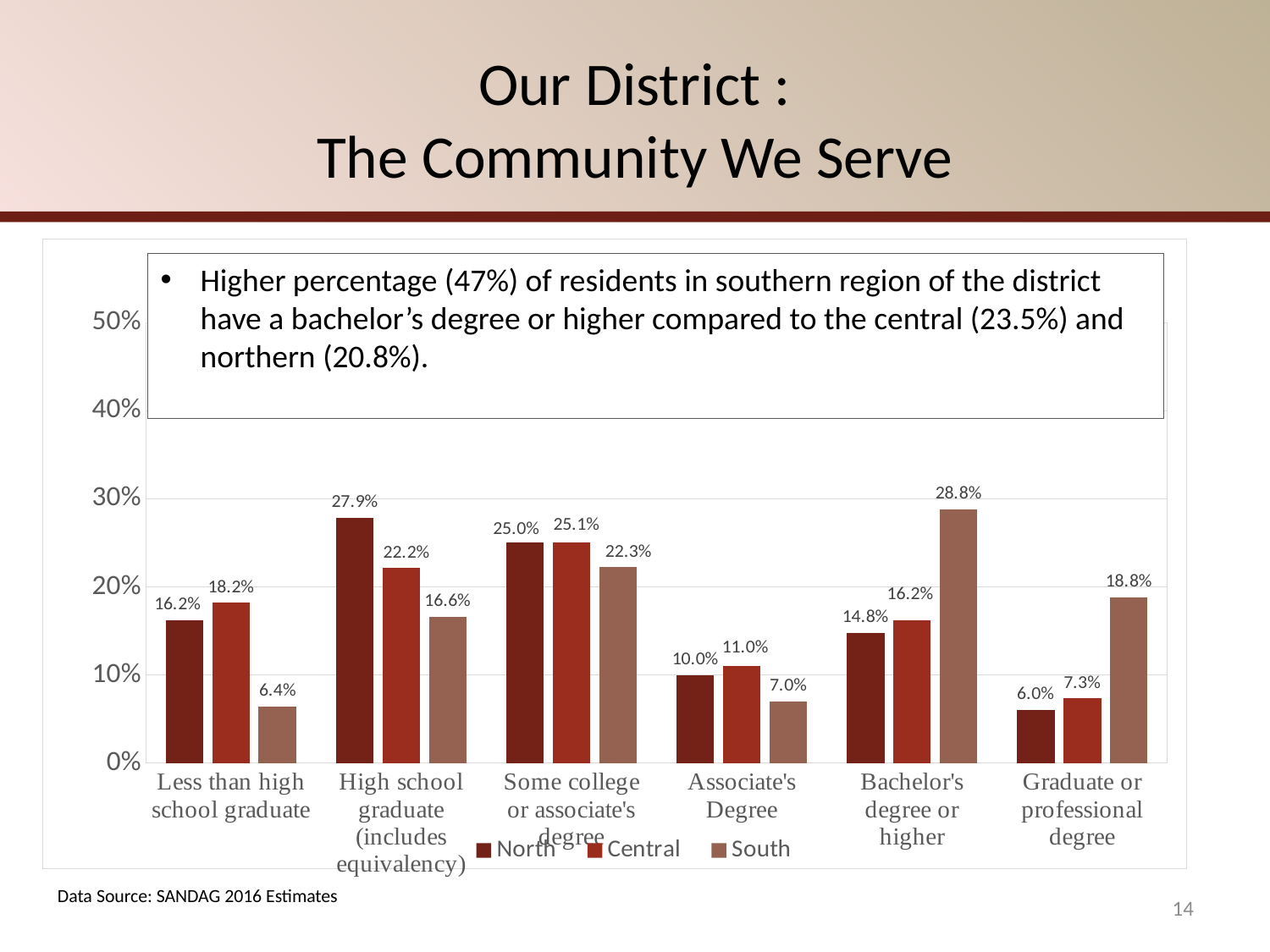
What kind of chart is shown on the slide? bar chart How many series does the legend list? 3 In the Less than high school graduate category, which is larger, the North value or the South value? North Which category has the highest value for the South series? Bachelor's degree or higher What are the three series named in the legend? North, Central, South What is the value for Central in the Associate's Degree category? 11.0% What is the difference between the South and North values in the Graduate or professional degree category? 12.8% What is the value for North in the High school graduate (includes equivalency) category? 27.9% How many education categories are shown on the x axis? 6 Which category has the lowest value for the North series? Graduate or professional degree What is the value for South in the Bachelor's degree or higher category? 28.8% Is the value for Central in the High school graduate (includes equivalency) category greater or less than 20%? greater